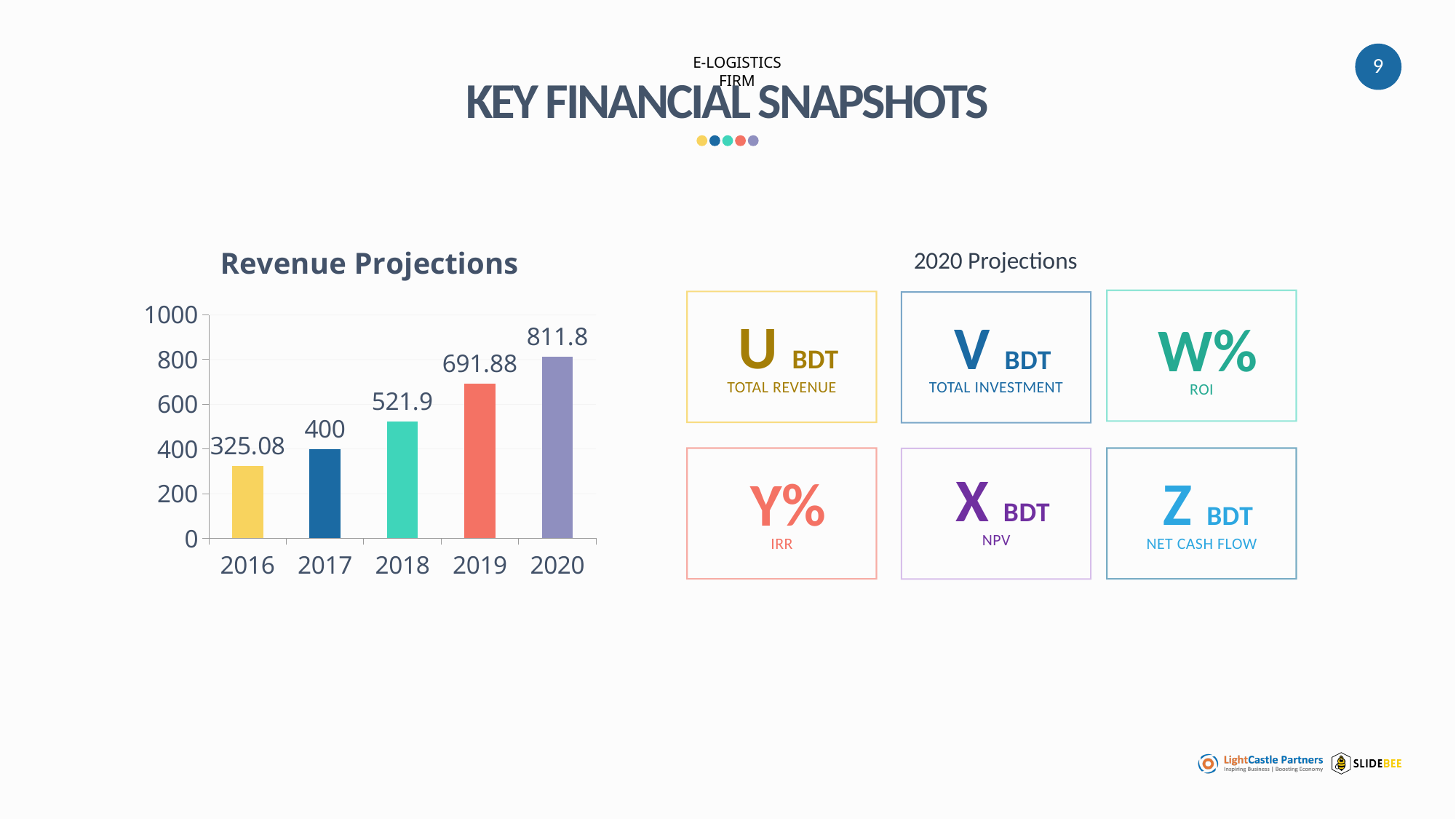
Which year has a larger revenue projection, 2017 or 2018? 2018 Is the revenue projection for 2019 greater or less than 600? greater Which year has the lowest revenue projection? 2016 What kind of chart is the Revenue Projections chart? bar chart What is the revenue projection for 2020? 811.8 How many years are shown in the Revenue Projections chart? 5 What is the title of the chart on the slide? Revenue Projections Which year has the highest revenue projection? 2020 What is the revenue projection for 2018? 521.9 What is the difference between the revenue projections for 2019 and 2017? 291.88 Do the revenue projections rise or fall from 2016 to 2020? rise What is the revenue projection for 2016? 325.08